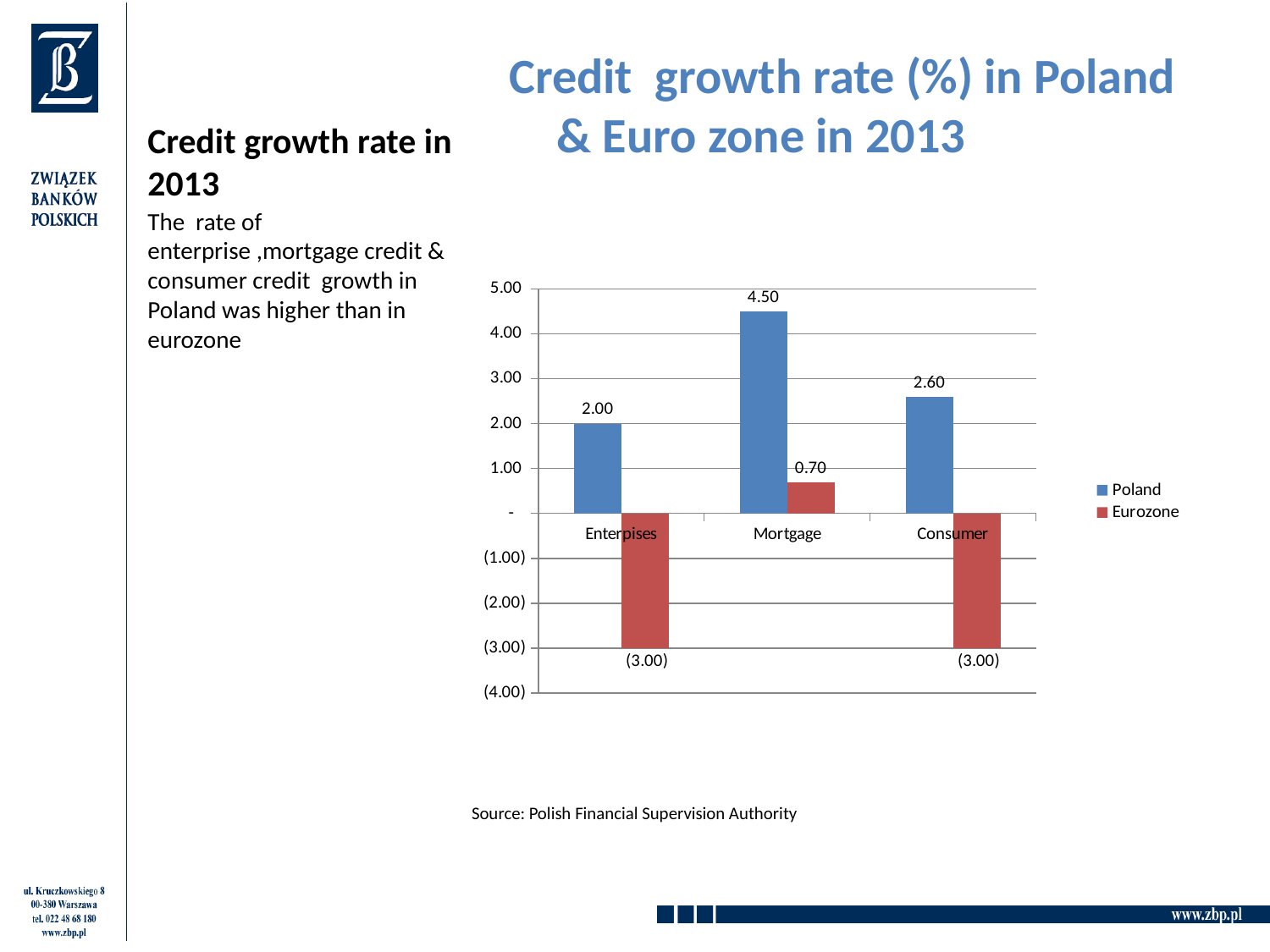
What is the credit growth rate for Poland in the Consumer category? 2.60 What is the credit growth rate for the Eurozone in the Mortgage category? 0.70 What is the credit growth rate for Poland in the Mortgage category? 4.50 How many categories are shown on the x axis of the chart? 3 Which is larger: Poland's credit growth rate for Enterprises or for Consumer? Consumer What kind of chart is shown on the slide? Bar chart How many series does the chart legend list? 2 What is the credit growth rate for the Eurozone in the Enterprises category? (3.00) Which category has the lowest credit growth rate for Poland? Enterprises Which category has the highest credit growth rate for Poland? Mortgage What is the source cited below the chart? Polish Financial Supervision Authority What is the difference between Poland's and the Eurozone's credit growth rate in the Mortgage category? 3.80